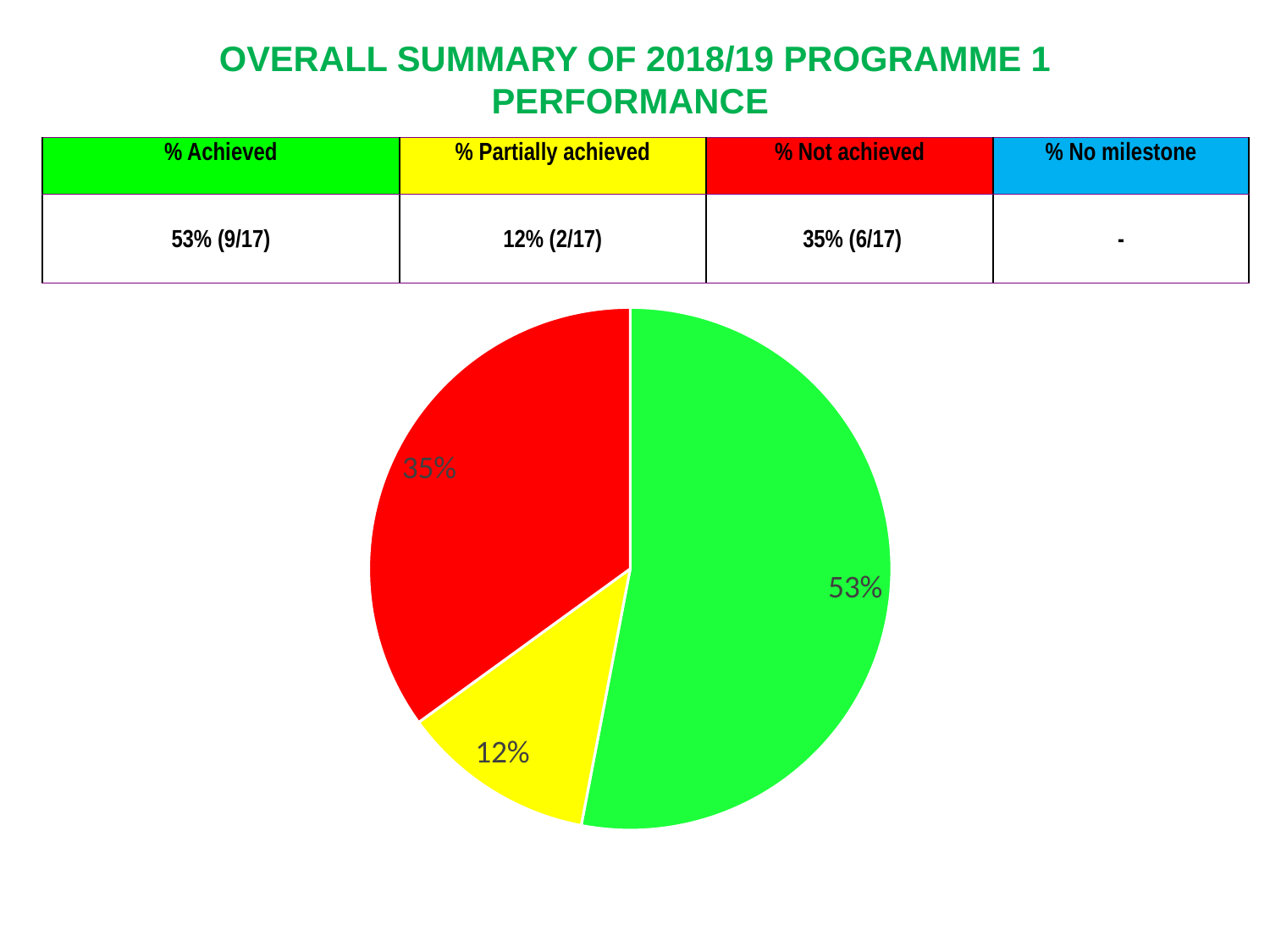
What is the difference in percentage points between the green slice and the red slice of the pie chart? 18 According to the table above the pie chart, what percentage of milestones was partially achieved? 12% (2/17) What percentage is shown on the red slice of the pie chart? 35% What is the title shown at the top of the slide? OVERALL SUMMARY OF 2018/19 PROGRAMME 1 PERFORMANCE What kind of chart is shown on the slide? pie chart How many slices does the pie chart have? 3 Which slice of the pie chart is the smallest? the yellow slice (12%) Which slice of the pie chart is the largest? the green slice (53%) What percentage is shown on the green slice of the pie chart? 53% Is the red slice or the yellow slice of the pie chart larger? the red slice What percentage is shown on the yellow slice of the pie chart? 12% What share of the pie does the red slice represent? 35%